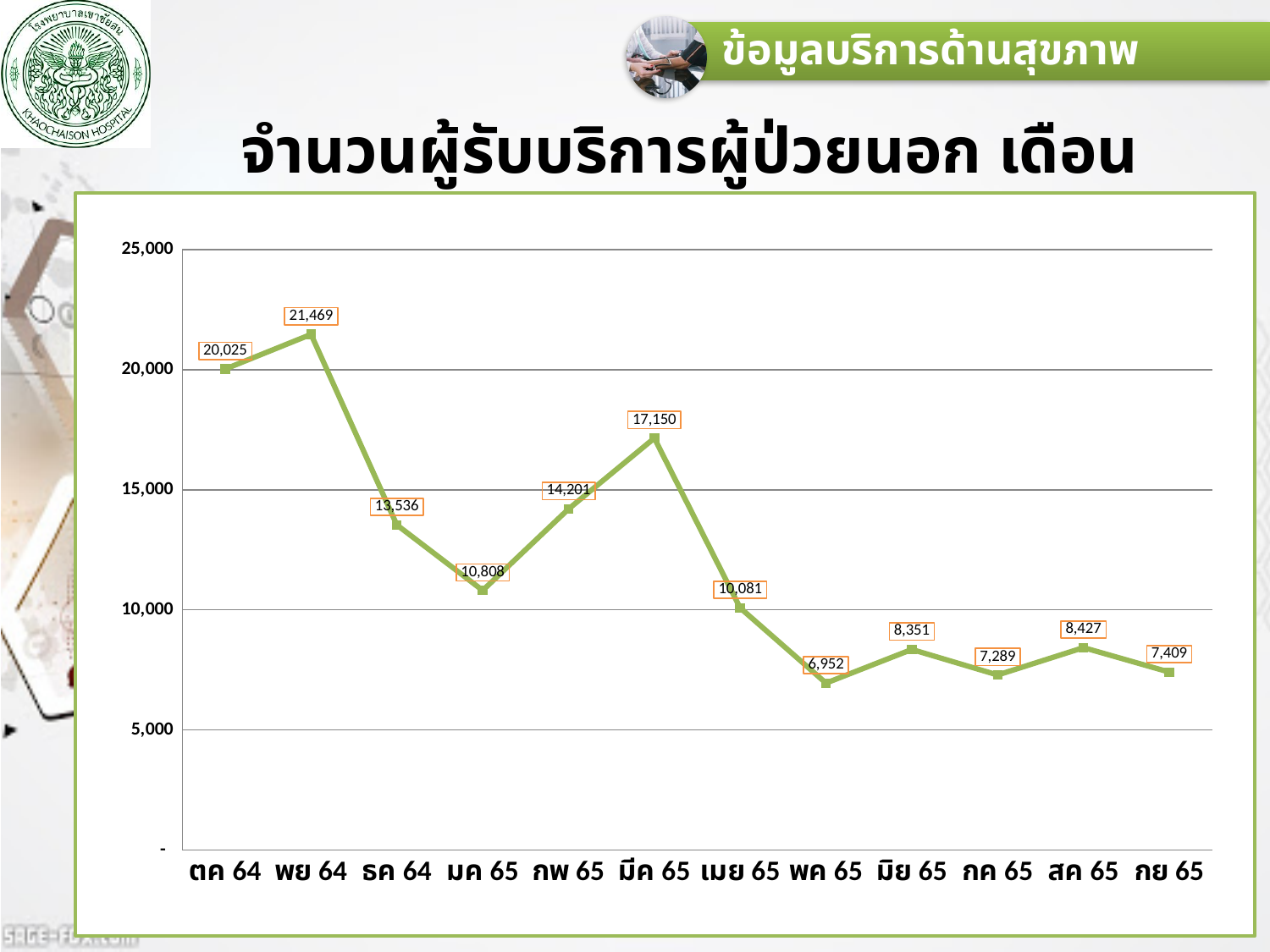
Which month has the lowest value? พค 65 Which month has the highest value? พย 64 Do the values rise or fall from มีค 65 to พค 65? fall What is the value for มีค 65? 17,150 What is the value for กย 65? 7,409 How many months are plotted on the x axis? 12 What kind of chart is shown on the slide? line chart What is the value for พย 64? 21,469 What is the difference between the values for ตค 64 and พย 64? 1,444 What is the difference between the values for มีค 65 and เมย 65? 7,069 Which is larger, the value for มิย 65 or the value for กค 65? มิย 65 Is the value for ธค 64 greater or less than 15,000? less